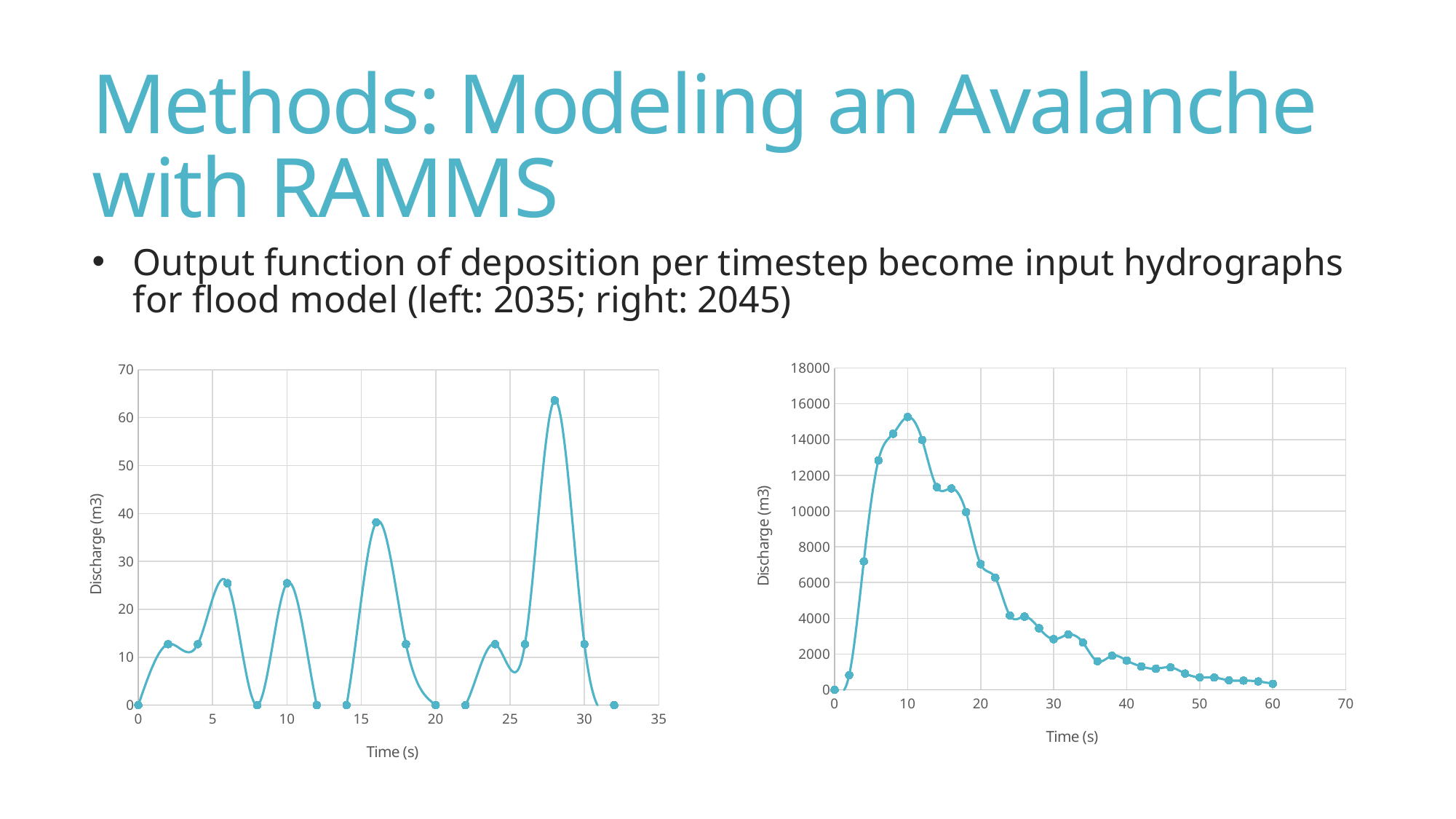
What kind of chart is the left chart? line chart On the left chart, what is the discharge value at time 8 s? 0 On the left chart, is the discharge at time 16 s greater or less than 40? less On the right chart, is the discharge at time 10 s greater or less than 14000? greater On the right chart, is the discharge at time 60 s greater or less than 2000? less On the left chart, which is larger: the discharge at time 16 s or at time 28 s? 28 s On the left chart, at what time (s) does the discharge reach its highest value? 28 What kind of chart is the right chart? line chart What is the y-axis label on the right chart? Discharge (m3) On the right chart, at what time (s) does the discharge reach its highest value? 10